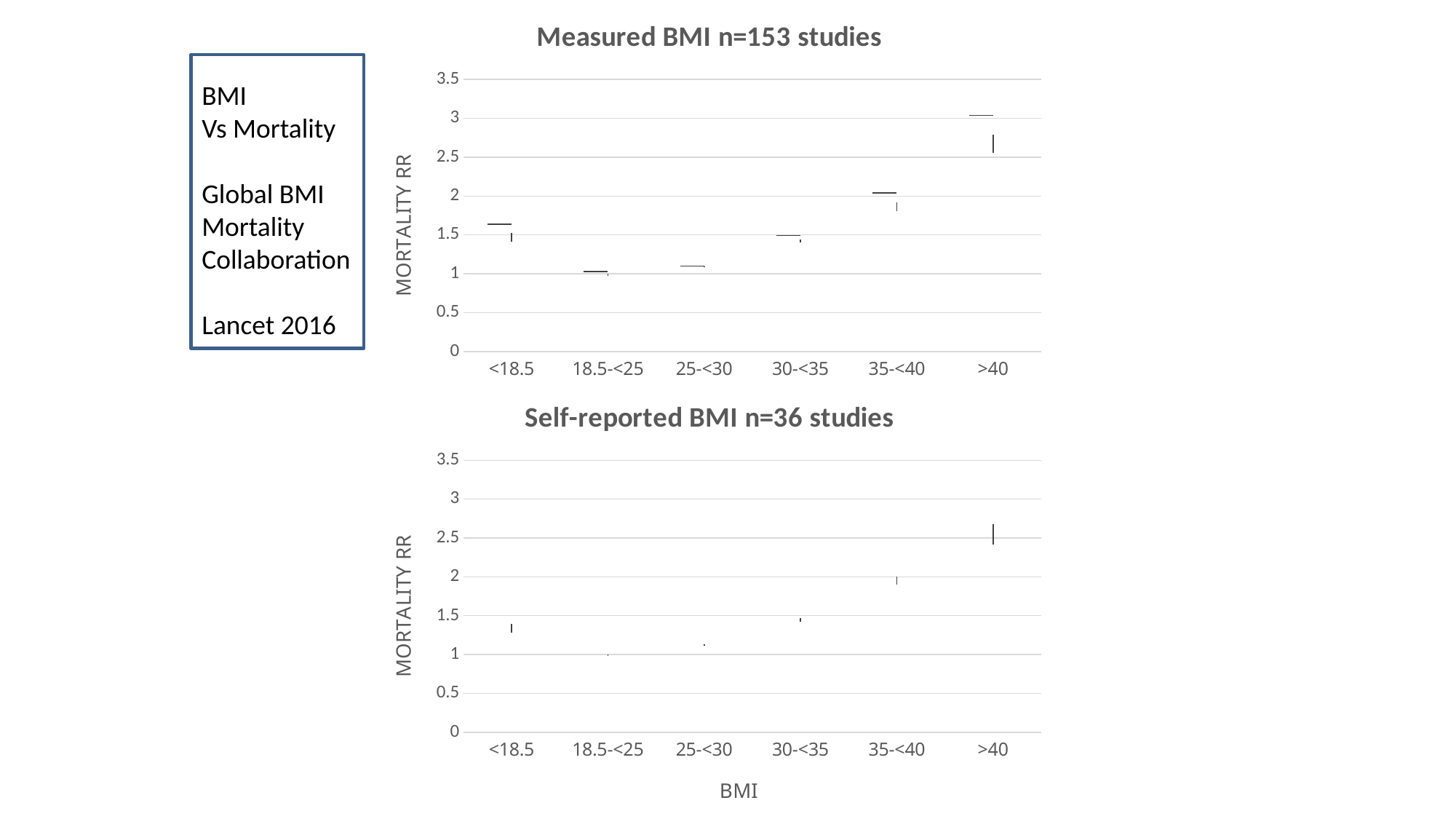
In the 'Measured BMI n=153 studies' chart, which has the higher mortality RR: <18.5 or >40? >40 In the 'Measured BMI n=153 studies' chart, do the mortality RR values rise or fall from 18.5-<25 to >40? rise In the 'Self-reported BMI n=36 studies' chart, which BMI category has the highest mortality RR? >40 In the 'Measured BMI n=153 studies' chart, is the mortality RR for 35-<40 greater or less than 1.5? greater In the 'Self-reported BMI n=36 studies' chart, is the mortality RR for >40 greater or less than 2? greater In the 'Self-reported BMI n=36 studies' chart, how many BMI categories are shown on the x axis? 6 In the 'Self-reported BMI n=36 studies' chart, which has the higher mortality RR: 35-<40 or 25-<30? 35-<40 In the 'Measured BMI n=153 studies' chart, which BMI category has the highest mortality RR? >40 In the 'Measured BMI n=153 studies' chart, how many BMI categories are shown on the x axis? 6 What is the y-axis title of the 'Self-reported BMI n=36 studies' chart? MORTALITY RR In the 'Measured BMI n=153 studies' chart, is the mortality RR for >40 greater or less than 2.5? greater